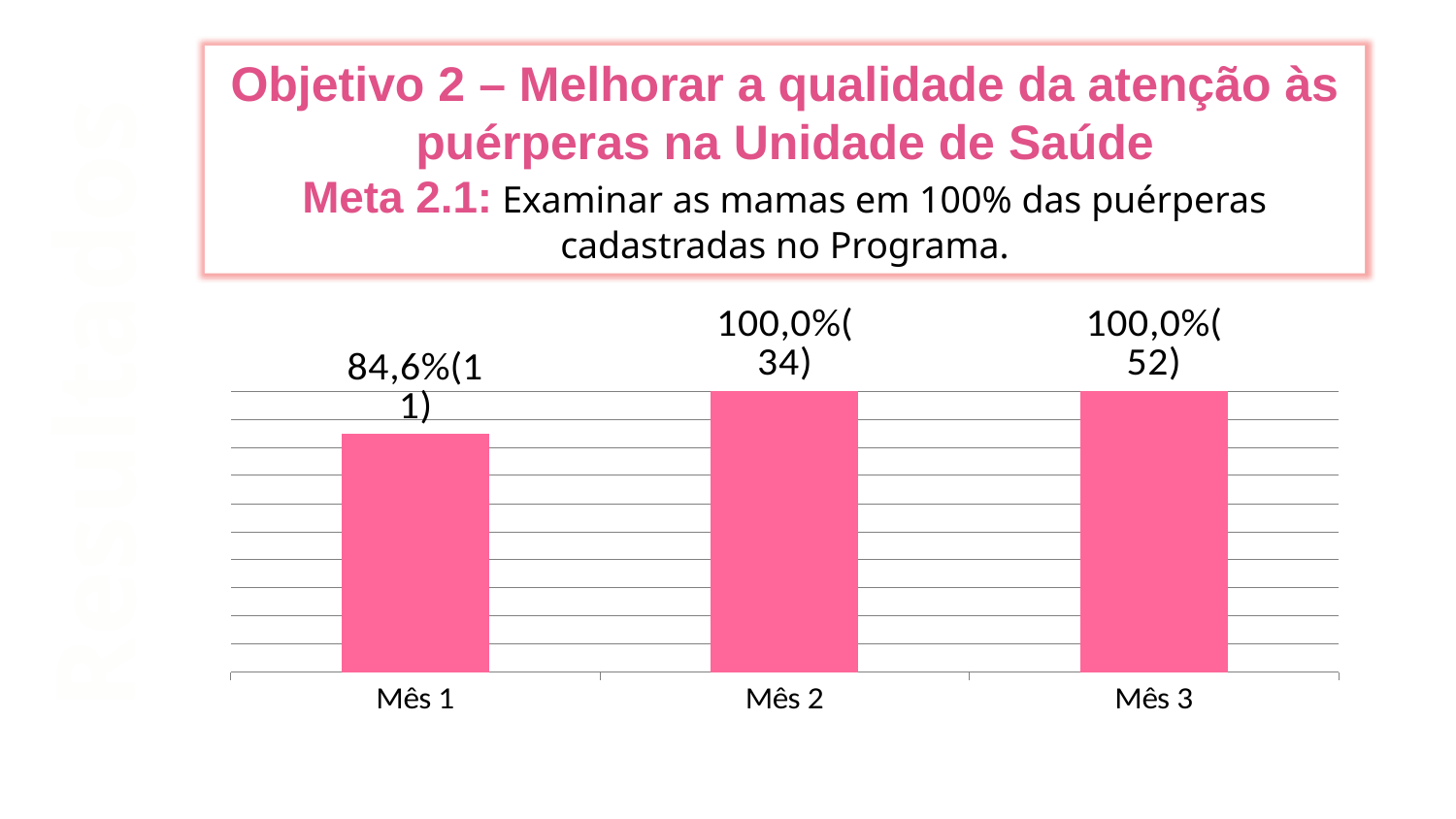
What number appears in parentheses in the data label for Mês 2? 34 Do the values rise or fall from Mês 1 to Mês 3? Rise What is the percentage value shown for Mês 1? 84,6% Which is larger, the value for Mês 1 or the value for Mês 2? Mês 2 What number appears in parentheses in the data label for Mês 1? 11 What is the percentage value shown for Mês 3? 100,0% What is the percentage value shown for Mês 2? 100,0% How many months (categories) are shown on the x axis? 3 What kind of chart is shown on the slide? Bar chart Which month has the lowest percentage value? Mês 1 What number appears in parentheses in the data label for Mês 3? 52 What is the difference in percentage between Mês 2 and Mês 1? 15,4 percentage points